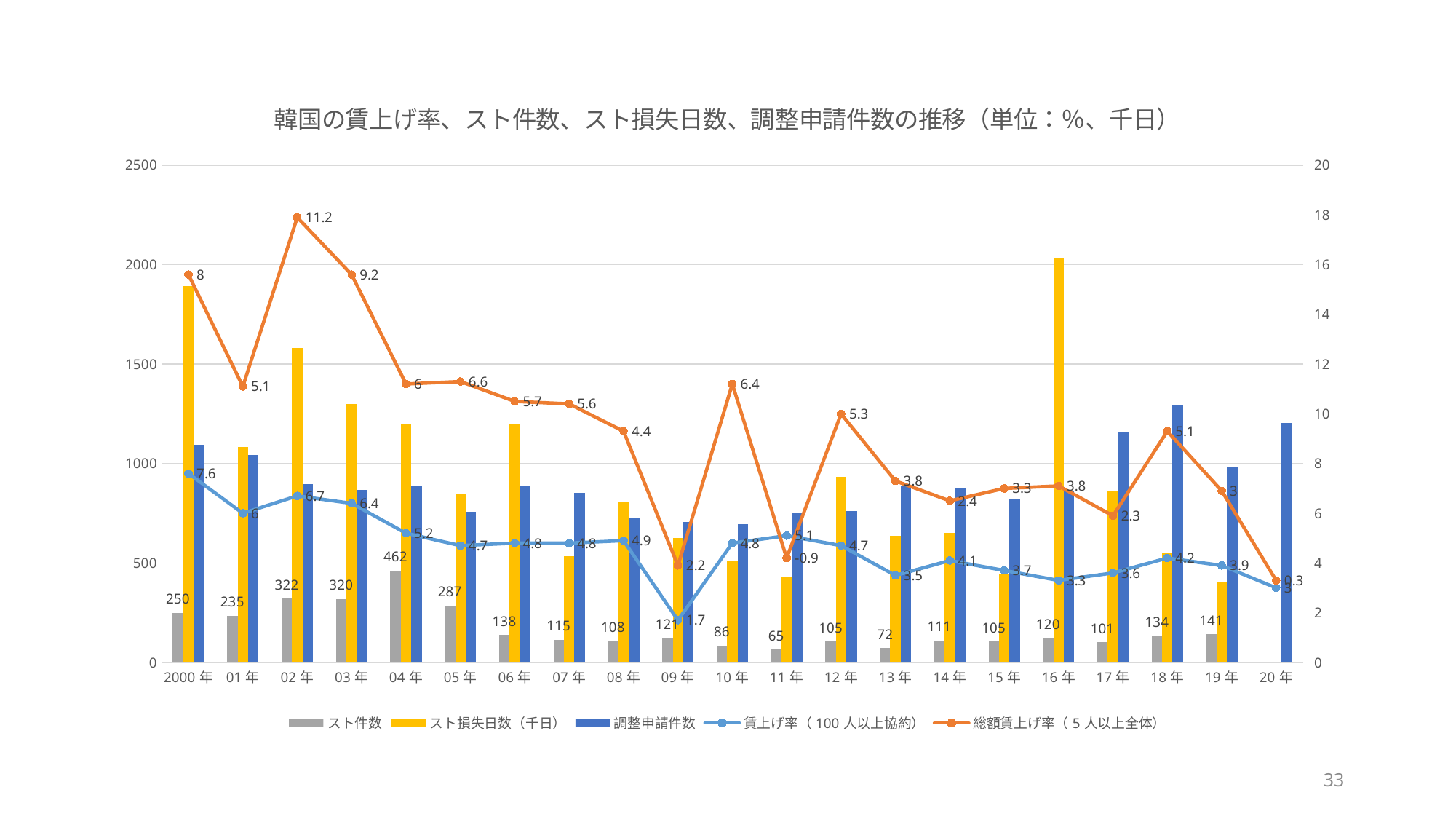
Which year has the lowest value for スト件数? 11 年 In which year does 総額賃上げ率（5人以上全体）reach its highest value? 02 年 What is the value of スト件数 in 02 年? 322 What is the value of 総額賃上げ率（5人以上全体）in 02 年? 11.2 In 2000 年, which is larger: 賃上げ率（100人以上協約）or 総額賃上げ率（5人以上全体）? 総額賃上げ率（5人以上全体） What is the value of 賃上げ率（100人以上協約）in 09 年? 1.7 What kind of chart is this? Combined bar and line chart Which year has the highest value for スト件数? 04 年 Is the value of スト損失日数（千日）in 2000 年 greater or less than 1500? greater What is the difference between スト件数 in 2000 年 and 01 年? 15 How many series does the legend list? 5 How many years are shown on the x axis? 21